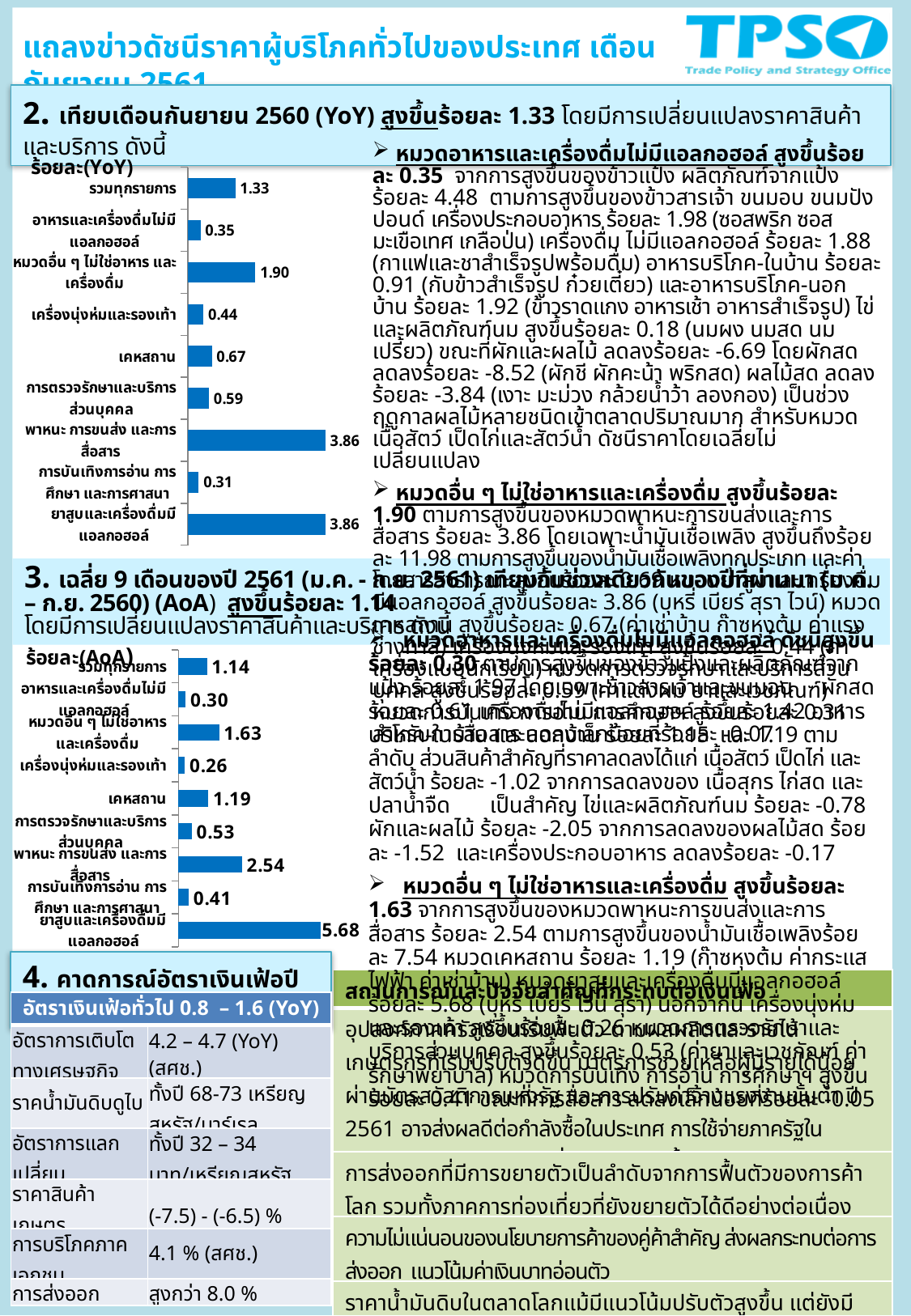
In the top chart (ร้อยละ(YoY)), what is the value for เคหสถาน? 0.67 In the top chart (ร้อยละ(YoY)), how many categories are plotted? 9 In the bottom chart (ร้อยละ(AoA)), which category has the lowest value? เครื่องนุ่งห่มและรองเท้า In the bottom chart (ร้อยละ(AoA)), which category has the highest value? ยาสูบและเครื่องดื่มมีแอลกอฮอล์ In the bottom chart (ร้อยละ(AoA)), which is larger: the value for เคหสถาน or the value for การตรวจรักษาและบริการส่วนบุคคล? เคหสถาน What type of chart is the top chart (ร้อยละ(YoY))? Bar chart In the bottom chart (ร้อยละ(AoA)), what is the value for การบันเทิงการอ่าน การศึกษา และการศาสนา? 0.41 In the top chart (ร้อยละ(YoY)), which category has the lowest value? การบันเทิงการอ่าน การศึกษา และการศาสนา In the top chart (ร้อยละ(YoY)), what is the value for รวมทุกรายการ? 1.33 In the bottom chart (ร้อยละ(AoA)), what is the difference between the values for พาหนะ การขนส่ง และการสื่อสาร and รวมทุกรายการ? 1.40 In the top chart (ร้อยละ(YoY)), what is the difference between the values for หมวดอื่น ๆ ไม่ใช่อาหาร และเครื่องดื่ม and อาหารและเครื่องดื่มไม่มีแอลกอฮอล์? 1.55 In the bottom chart (ร้อยละ(AoA)), what is the value for ยาสูบและเครื่องดื่มมีแอลกอฮอล์? 5.68